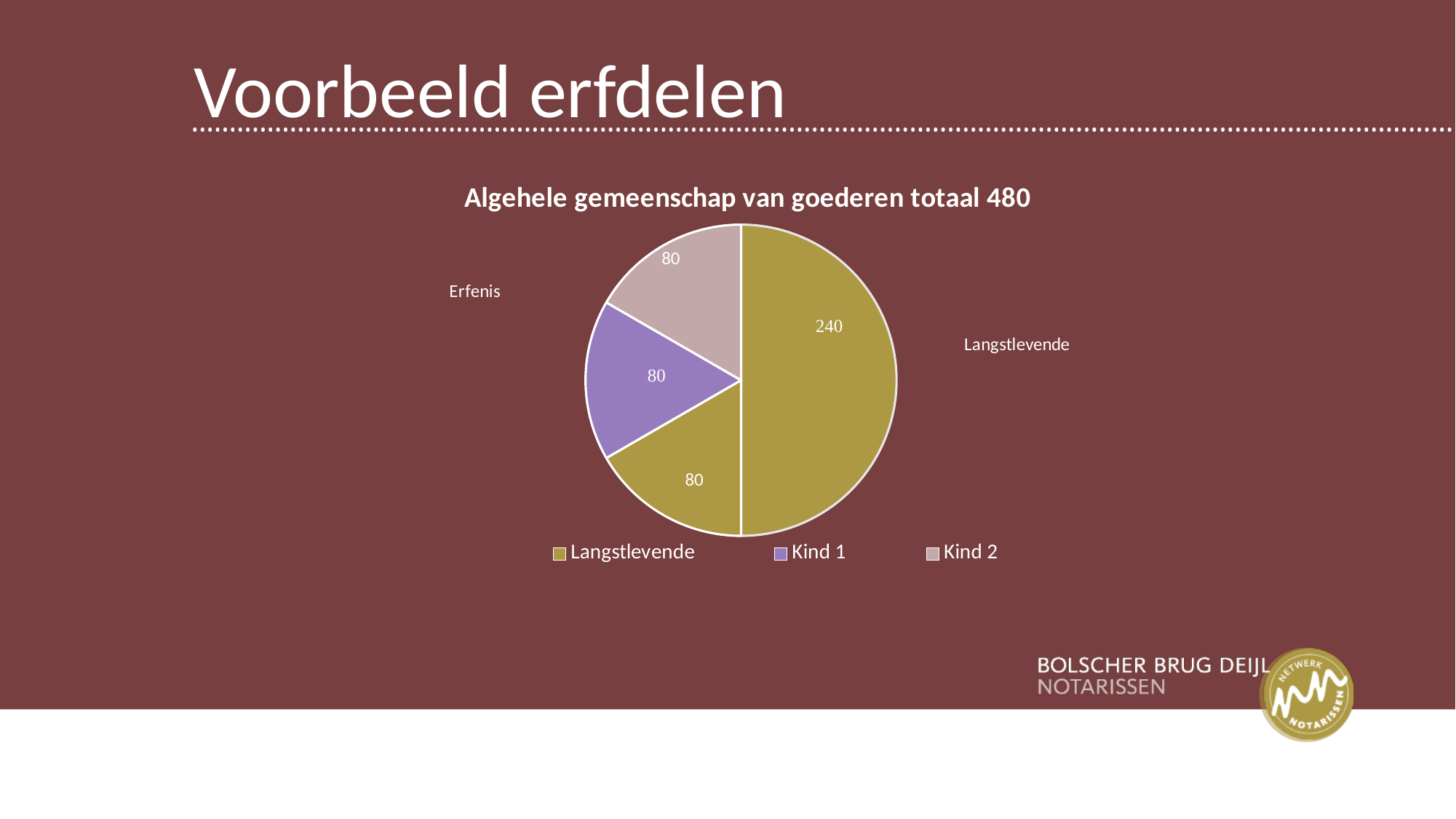
Which is larger: the Langstlevende slice labelled 240 or the Kind 2 slice? the Langstlevende slice labelled 240 What is the value of the Kind 2 slice? 80 What is the total of all slices in the pie chart? 480 How many slices are labelled 80? 3 What is the difference between the 240 slice and the Kind 1 slice? 160 How many entries does the legend list? 3 What is the value of the largest slice in the pie chart? 240 What kind of chart is shown on the slide? pie chart How many slices does the pie chart have? 4 What is the title of the chart? Algehele gemeenschap van goederen totaal 480 What is the value of the Kind 1 (purple) slice? 80 What share of the pie does the 240 slice represent? 50%